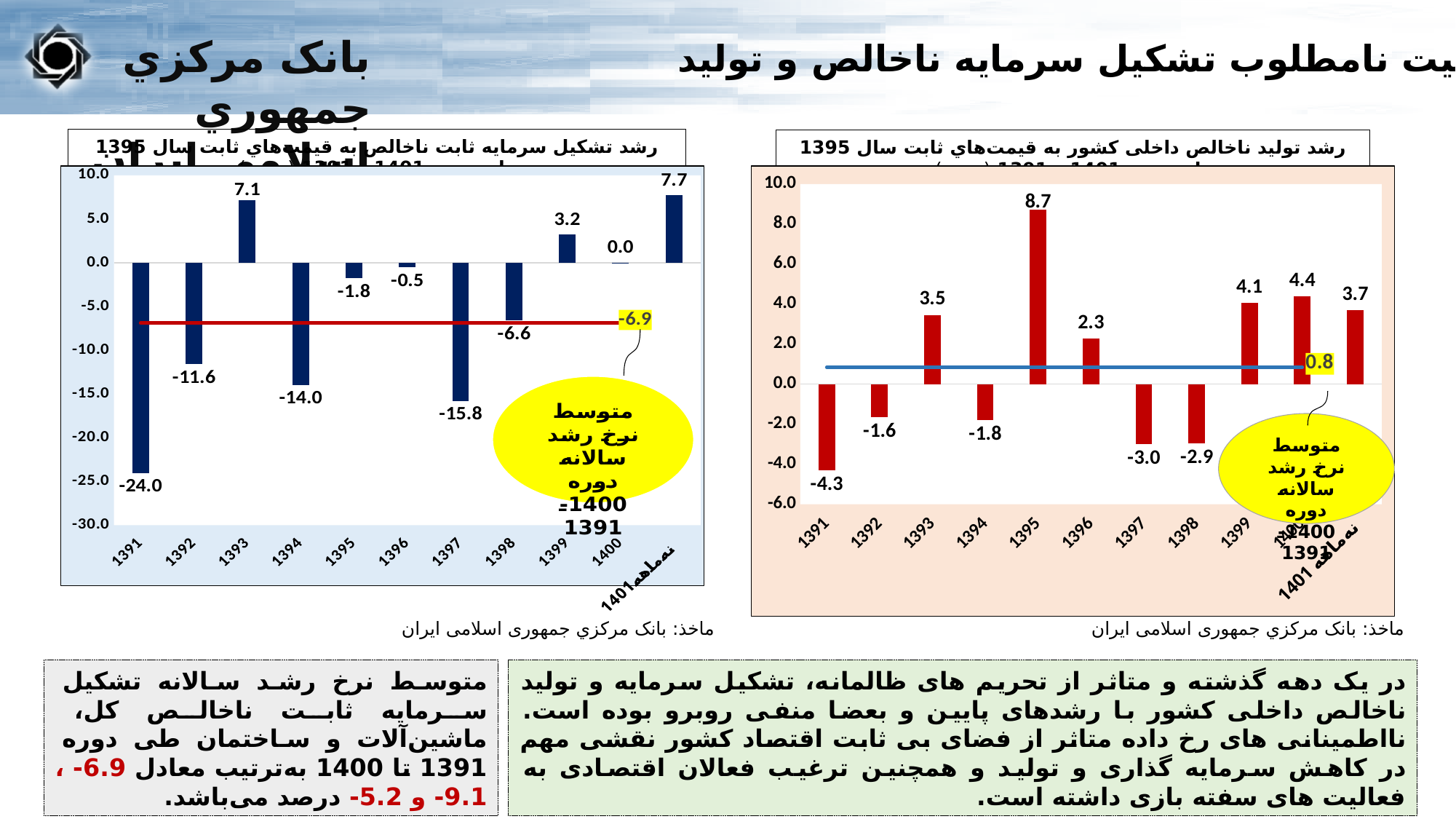
In the right-hand chart (GDP growth), what is the difference between the values for 1400 and 1399? 0.3 In the right-hand chart (GDP growth), what is the value for 1395? 8.7 In the left-hand chart (gross fixed capital formation growth), what value is labelled on the horizontal average line? -6.9 In the right-hand chart (GDP growth), how many bars are plotted? 11 In the left-hand chart (gross fixed capital formation growth), which year has the highest value? نه‌ماهه 1401 In the left-hand chart (gross fixed capital formation growth), what is the value for 1391? -24.0 In the right-hand chart (GDP growth), what value is labelled on the horizontal average line? 0.8 In the left-hand chart (gross fixed capital formation growth), which is larger, the value for 1393 or the value for 1399? 1393 In the left-hand chart (gross fixed capital formation growth), what is the difference between the values for 1392 and 1394? 2.4 What type of chart is the right-hand chart (GDP growth)? Bar chart In the left-hand chart (gross fixed capital formation growth), what is the value for 1397? -15.8 In the right-hand chart (GDP growth), which year has the lowest value? 1391